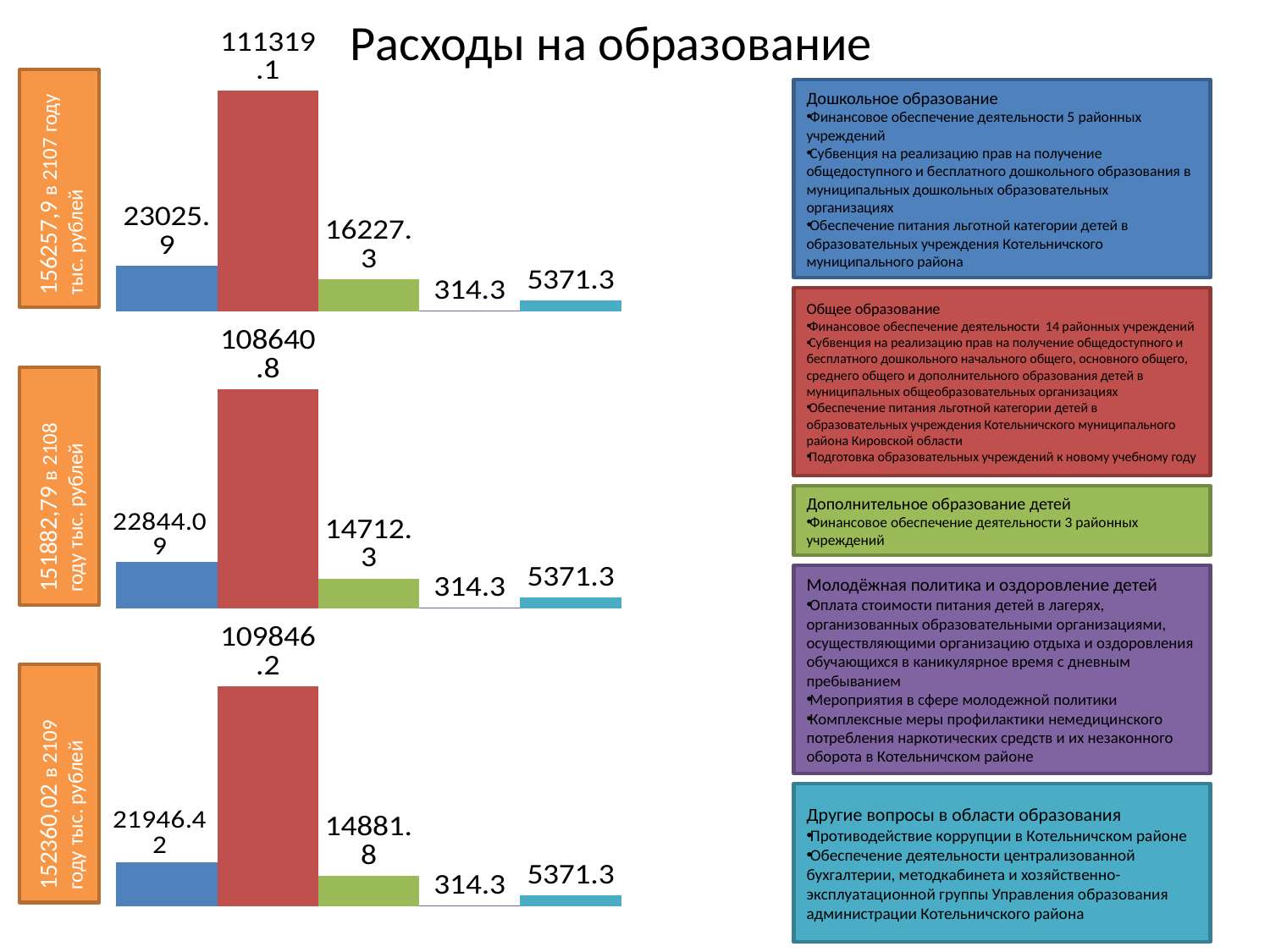
In the top chart, what is the value of the red bar (Общее образование)? 111319.1 In the middle chart, which is larger: the green bar or the cyan bar? The green bar (14712.3) In the top chart, what is the difference between the blue bar (23025.9) and the green bar (16227.3)? 6798.6 How many bars does the top chart contain? 5 In the middle chart, what is the value of the blue bar (Дошкольное образование)? 22844.09 In the bottom chart, which category has the lowest value? Молодёжная политика и оздоровление детей (purple bar) In the bottom chart, what is the difference between the red bar (109846.2) and the blue bar (21946.42)? 87899.78 What is the total of all five bars in the top chart? 156257.9 In the bottom chart, what is the value of the cyan bar (Другие вопросы в области образования)? 5371.3 In the top chart, which category has the highest value? Общее образование (red bar) What type of chart is used on this slide? Bar chart In the bottom chart, what is the value of the green bar (Дополнительное образование детей)? 14881.8